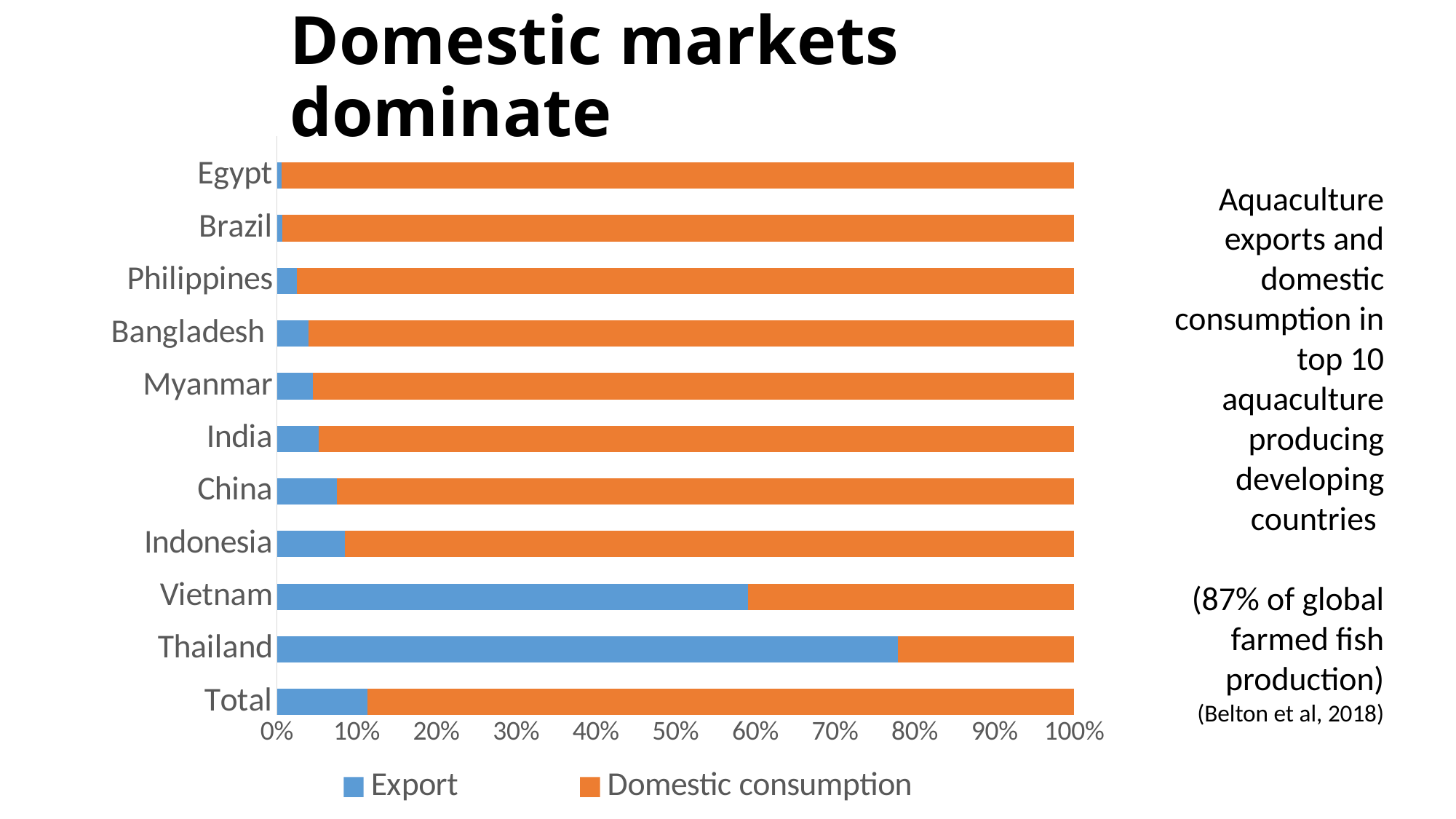
Which category has the largest Export share? Thailand Is the Export share for China greater or less than 10%? less Which has the larger Export share, Vietnam or Indonesia? Vietnam How many series does the legend list? 2 Is the Export share for Total greater or less than 10%? greater Is the Export share for Vietnam greater or less than 50%? greater What value does each stacked bar add up to on the x axis? 100% What kind of chart is shown on the slide? stacked bar chart How many categories (bars) are shown on the chart? 11 Which category has the smallest Domestic consumption share? Thailand What are the two series named in the legend? Export and Domestic consumption